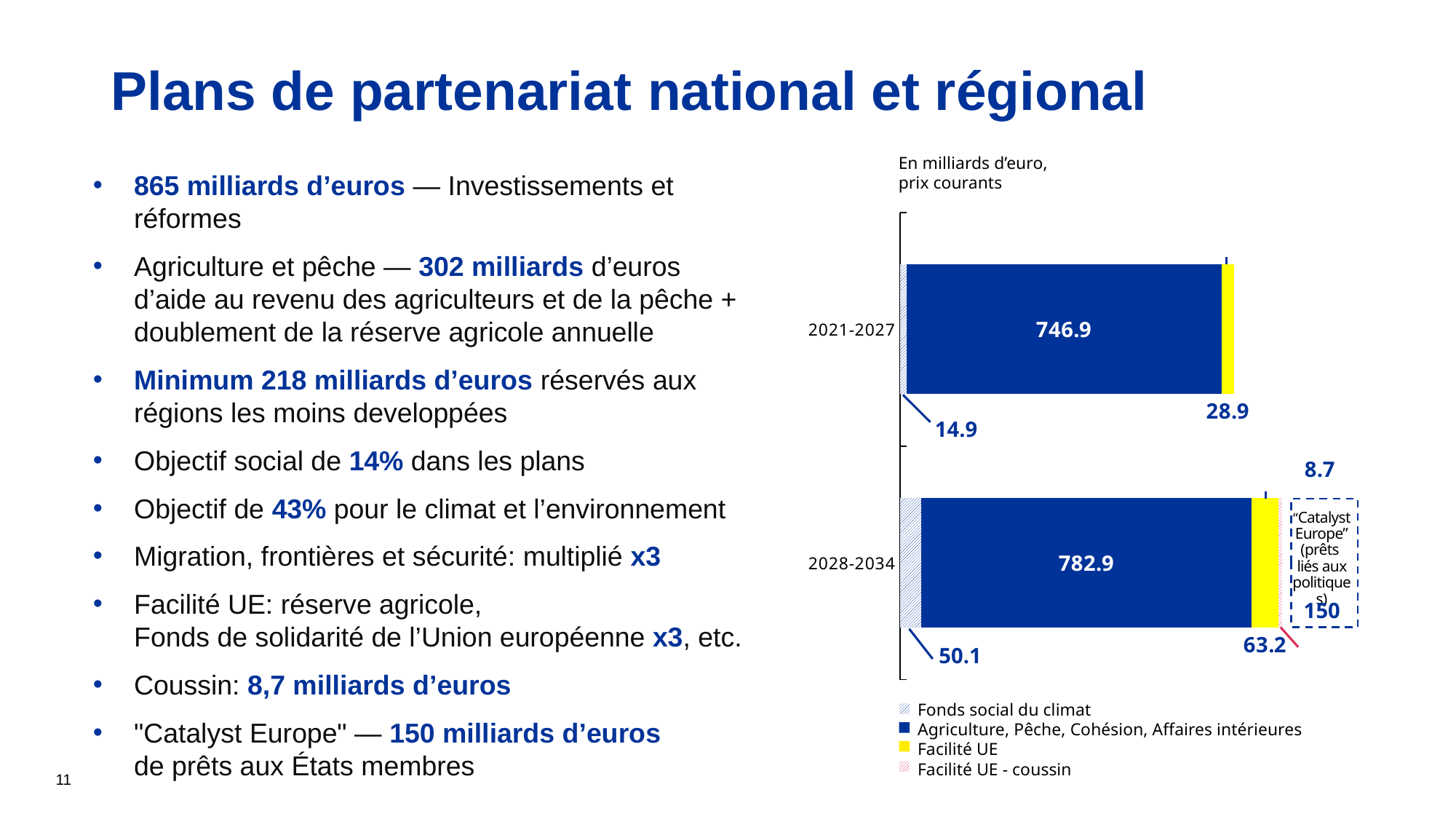
In what unit are the chart values expressed, according to the note above the chart? En milliards d'euro, prix courants What is the difference between the Facilité UE values for 2028-2034 and 2021-2027? 34.3 What is the value of the Agriculture, Pêche, Cohésion, Affaires intérieures segment for 2028-2034? 782.9 What is the value of the Agriculture, Pêche, Cohésion, Affaires intérieures segment for 2021-2027? 746.9 Which period has the larger Fonds social du climat value, 2021-2027 or 2028-2034? 2028-2034 What is the value of the Fonds social du climat segment for 2028-2034? 50.1 What is the value of the Facilité UE segment for 2021-2027? 28.9 How many periods (categories) are shown on the chart? 2 What type of chart is shown on the slide? bar chart What is the total of the 2021-2027 stacked bar (Fonds social du climat, Agriculture/Pêche/Cohésion/Affaires intérieures and Facilité UE)? 790.7 How many series does the legend list? 4 What is the value of the Facilité UE - coussin segment for 2028-2034? 8.7